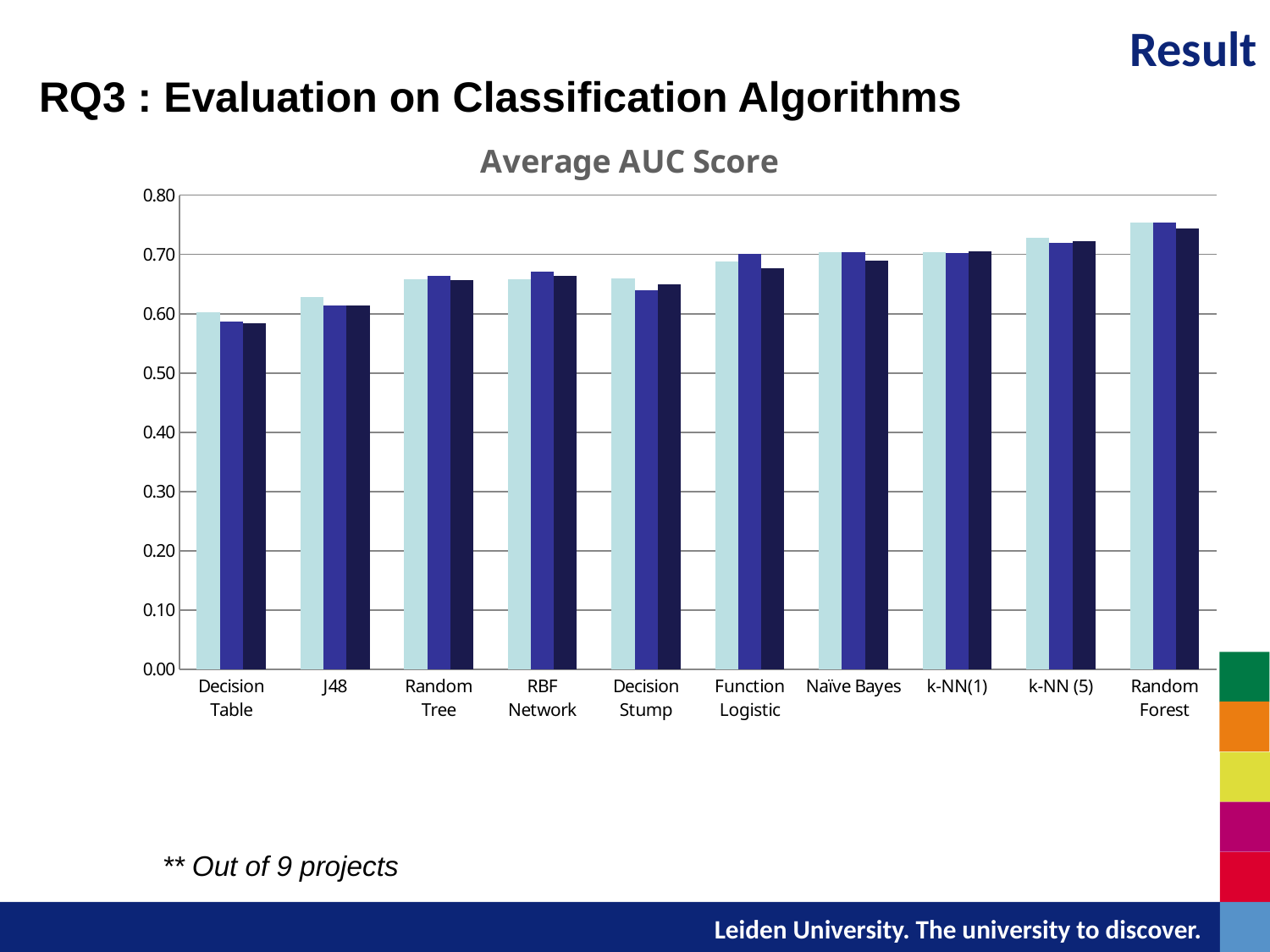
How many classification algorithms are shown on the x axis of the chart? 10 Which has a higher average AUC score, Random Forest or Decision Table? Random Forest Are the values for Random Tree greater or less than 0.70? less Which has a higher average AUC score, J48 or Random Tree? Random Tree Are the values for Random Forest greater or less than 0.70? greater Are the values for J48 greater or less than 0.70? less Which algorithm has the highest average AUC score in the chart? Random Forest How many bars are plotted for each algorithm in the chart? 3 What kind of chart is shown on the slide? bar chart Which algorithm has the lowest average AUC score in the chart? Decision Table Do the average AUC scores generally rise or fall from left to right along the x axis? rise What is the title of the chart? Average AUC Score